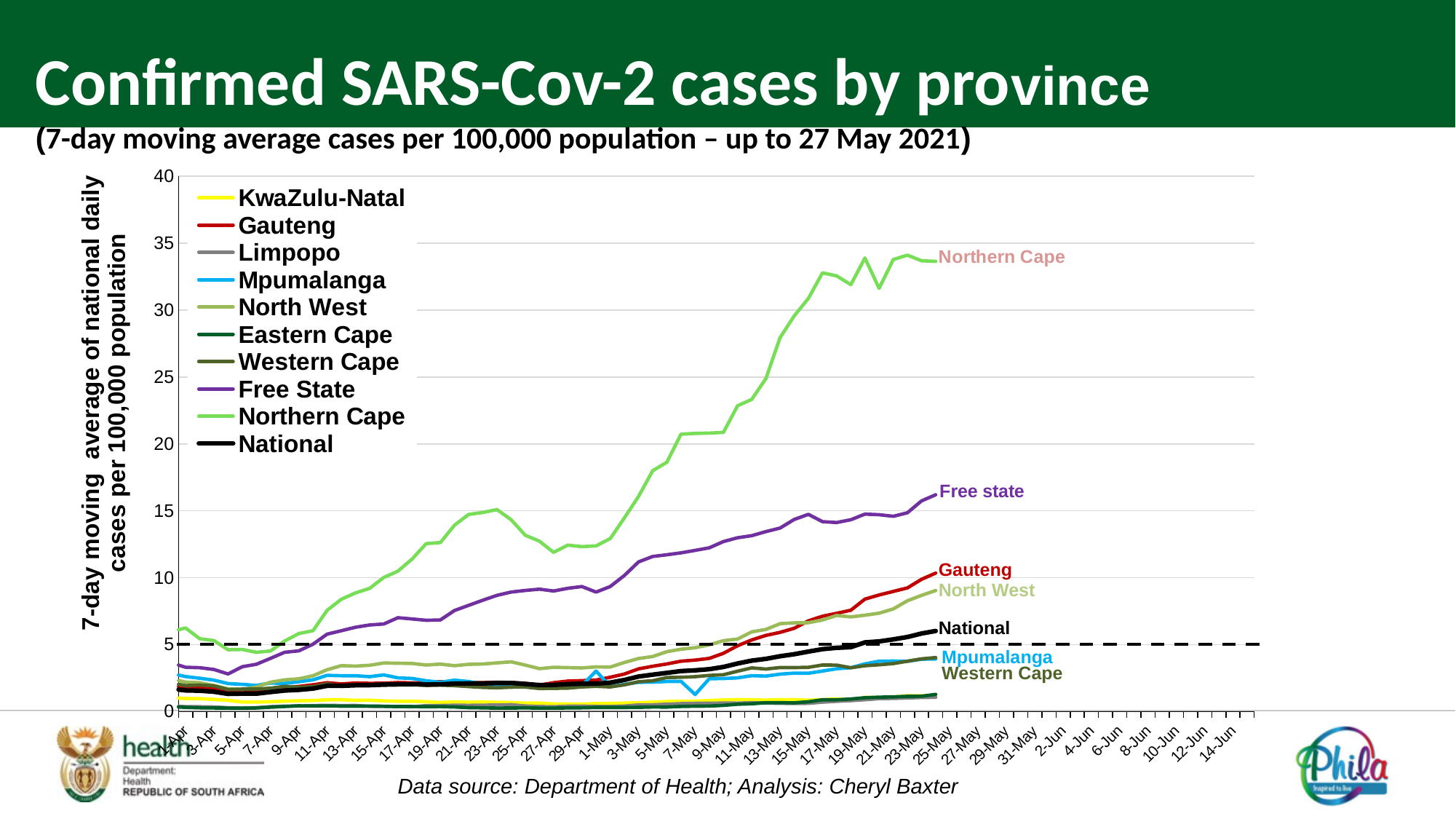
Which series has the highest value at the end of the plotted period (25-May)? Northern Cape How many series does the legend list? 10 Does the National line rise or fall between 1-Apr and 25-May? rise Is the value for Free State on 25-May greater or less than 15? greater Is the value for National on 25-May greater or less than 5? greater On 25-May, which is larger: the value for Northern Cape or the value for Free State? Northern Cape On 25-May, which is larger: the value for Free State or the value for Gauteng? Free State Is the value for Mpumalanga on 25-May greater or less than 5? less At what value on the y axis is the horizontal dashed line drawn? 5 What kind of chart is shown on the slide? line chart Does the Northern Cape line rise or fall between 1-May and 25-May? rise